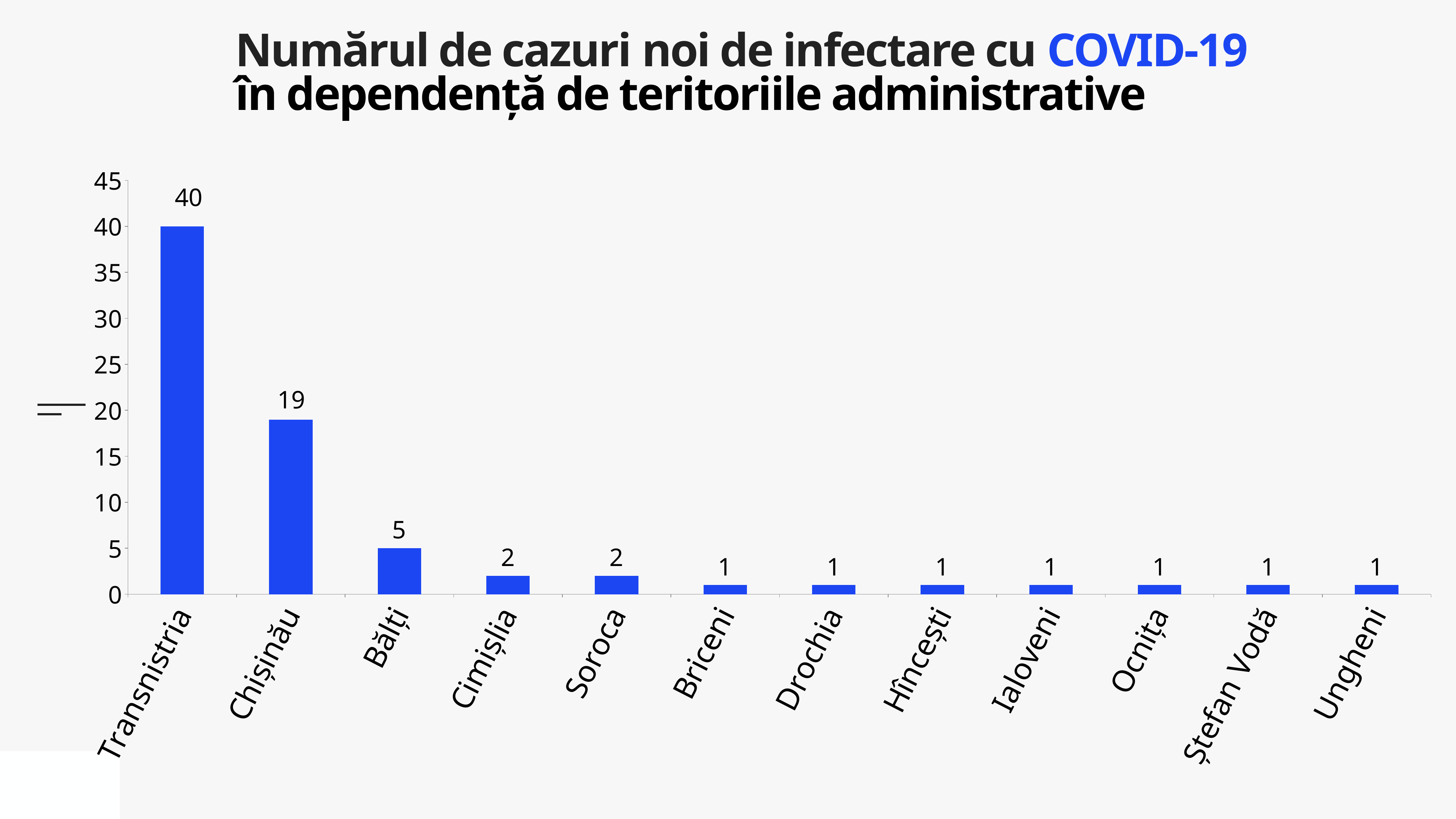
Do the values rise or fall from left to right along the x axis? fall What is the difference between the values for Transnistria and Chișinău? 21 How many categories are shown on the x axis? 12 What is the value for Transnistria? 40 What is the value for Chișinău? 19 What is the value for Soroca? 2 What is the difference between the values for Chișinău and Bălți? 14 Which is larger, the value for Bălți or the value for Cimișlia? Bălți What is the value for Bălți? 5 What kind of chart is shown on the slide? bar chart Is the value for Chișinău greater or less than 15? greater Which category has the highest value? Transnistria